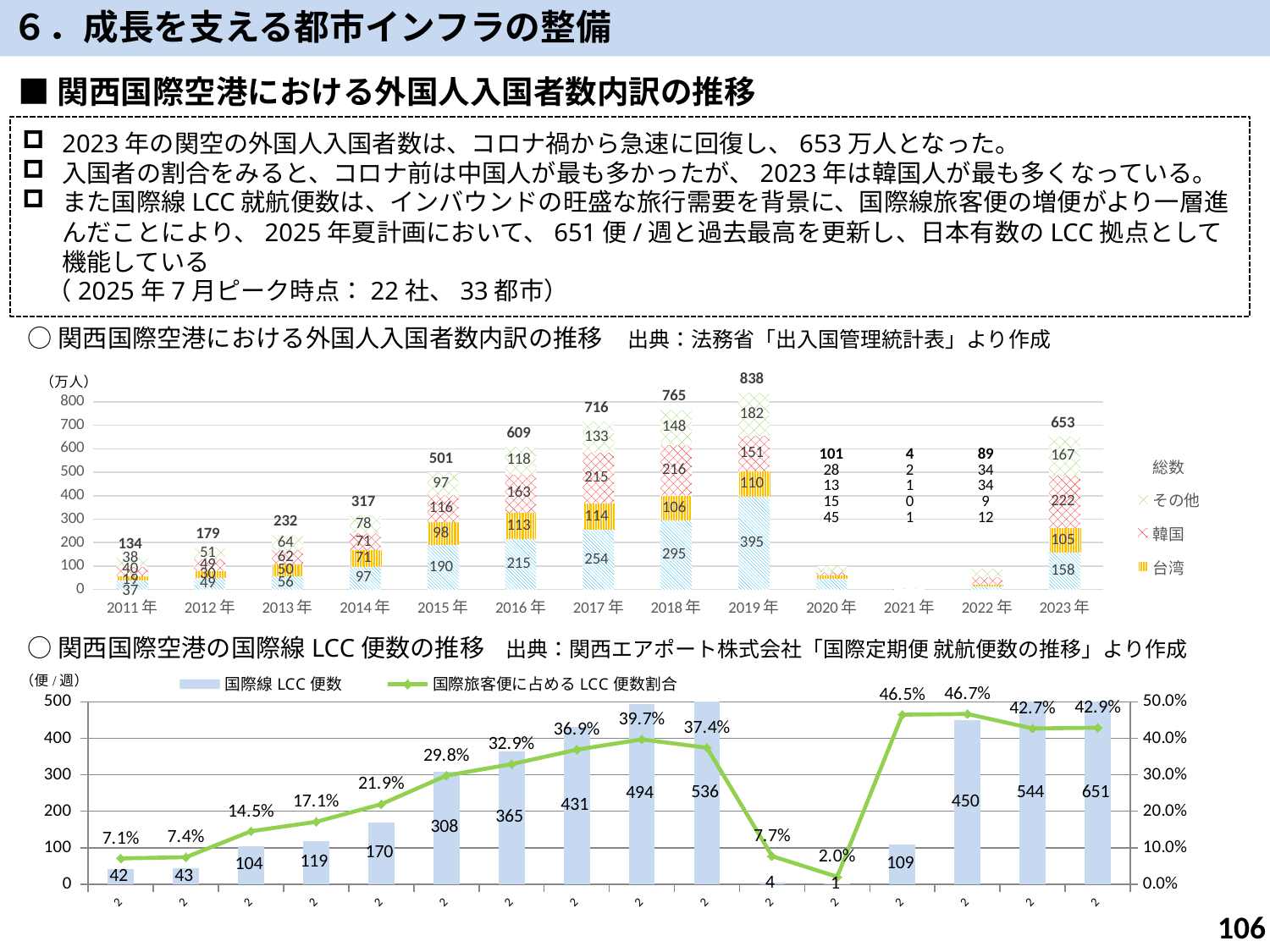
In the bottom chart, what is the lowest LCC share (国際旅客便に占めるLCC便数割合) shown on the line? 2.0% In the top chart, what is the 韓国 value for 2023年? 222 In the top chart, how many years are shown on the x axis? 13 In the bottom chart (関西国際空港の国際線LCC便数の推移), what is the highest number of international LCC flights shown? 651 In the top chart, is the total for 2018年 greater or less than 700? greater In the top chart (関西国際空港における外国人入国者数内訳の推移), what is the total number of foreign entrants (総数) for 2019年? 838 In the top chart, what is the difference between the totals for 2019年 and 2023年? 185 In the bottom chart, how many series does the legend list? 2 In the top chart, which year has the highest total number of foreign entrants? 2019年 In the bottom chart, what is the highest LCC share shown on the line? 46.7% In the top chart, what is the total number of foreign entrants for 2023年? 653 In the top chart, which year has the lowest total number of foreign entrants? 2021年